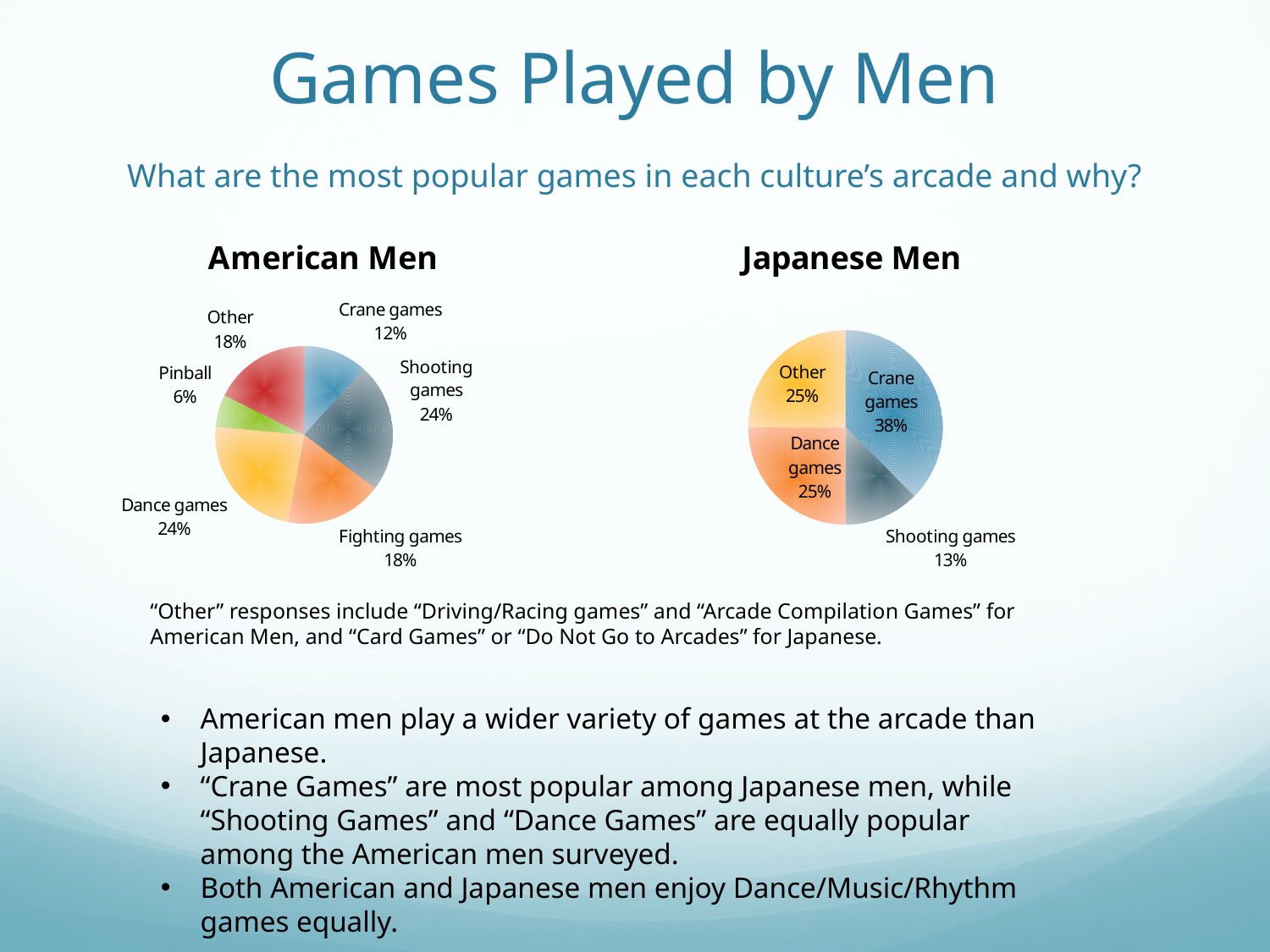
In the Japanese Men chart, what is the difference between the Crane games and Other percentages? 13% In the Japanese Men chart, which category has the largest slice? Crane games In the American Men chart, what is the difference between the Shooting games and Crane games percentages? 12% In the Japanese Men chart, which category has the smallest slice? Shooting games In the American Men chart, which category has the smallest slice? Pinball In the American Men chart, what share of the pie is Shooting games? 24% In the American Men chart, what percentage is Pinball? 6% How many categories does the American Men pie chart have? 6 What type of chart is used for Japanese Men? Pie chart In the Japanese Men chart, what percentage is Shooting games? 13% In the Japanese Men chart, what share of the pie is Crane games? 38% Which is larger: Crane games for American Men or Crane games for Japanese Men? Japanese Men